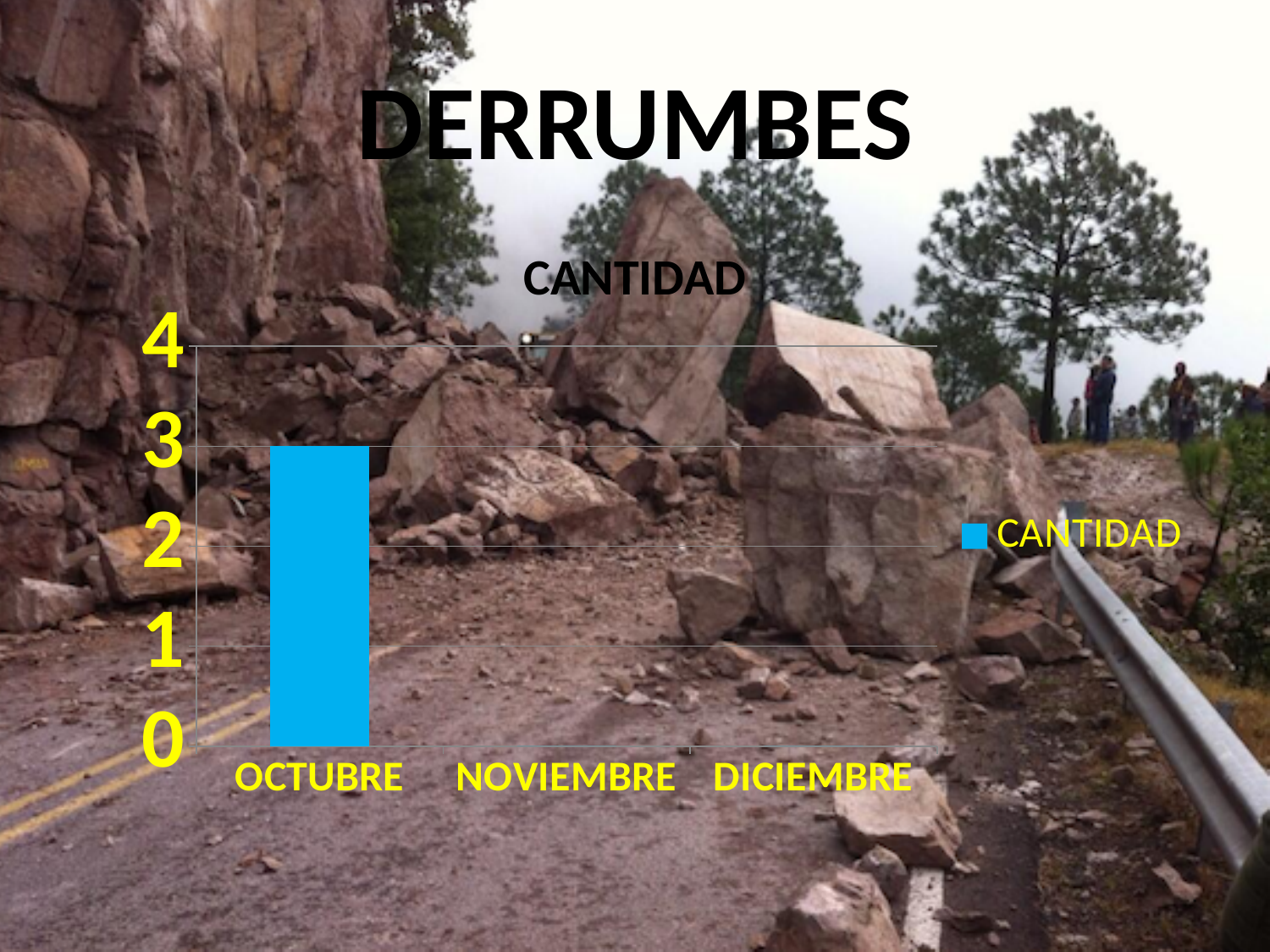
How many categories are shown on the x axis of the chart? 3 Which is larger, the value for OCTUBRE or the value for NOVIEMBRE? OCTUBRE What kind of chart is shown on the slide? bar chart Is the value for OCTUBRE greater or less than 2? greater What is the highest value shown on the y axis of the chart? 4 Which category has the highest value in the CANTIDAD chart? OCTUBRE What is the value for OCTUBRE in the CANTIDAD chart? 3 Is the value for OCTUBRE greater or less than 4? less How many series does the legend list? 1 What is the title of the chart? CANTIDAD What is the name of the series listed in the legend? CANTIDAD